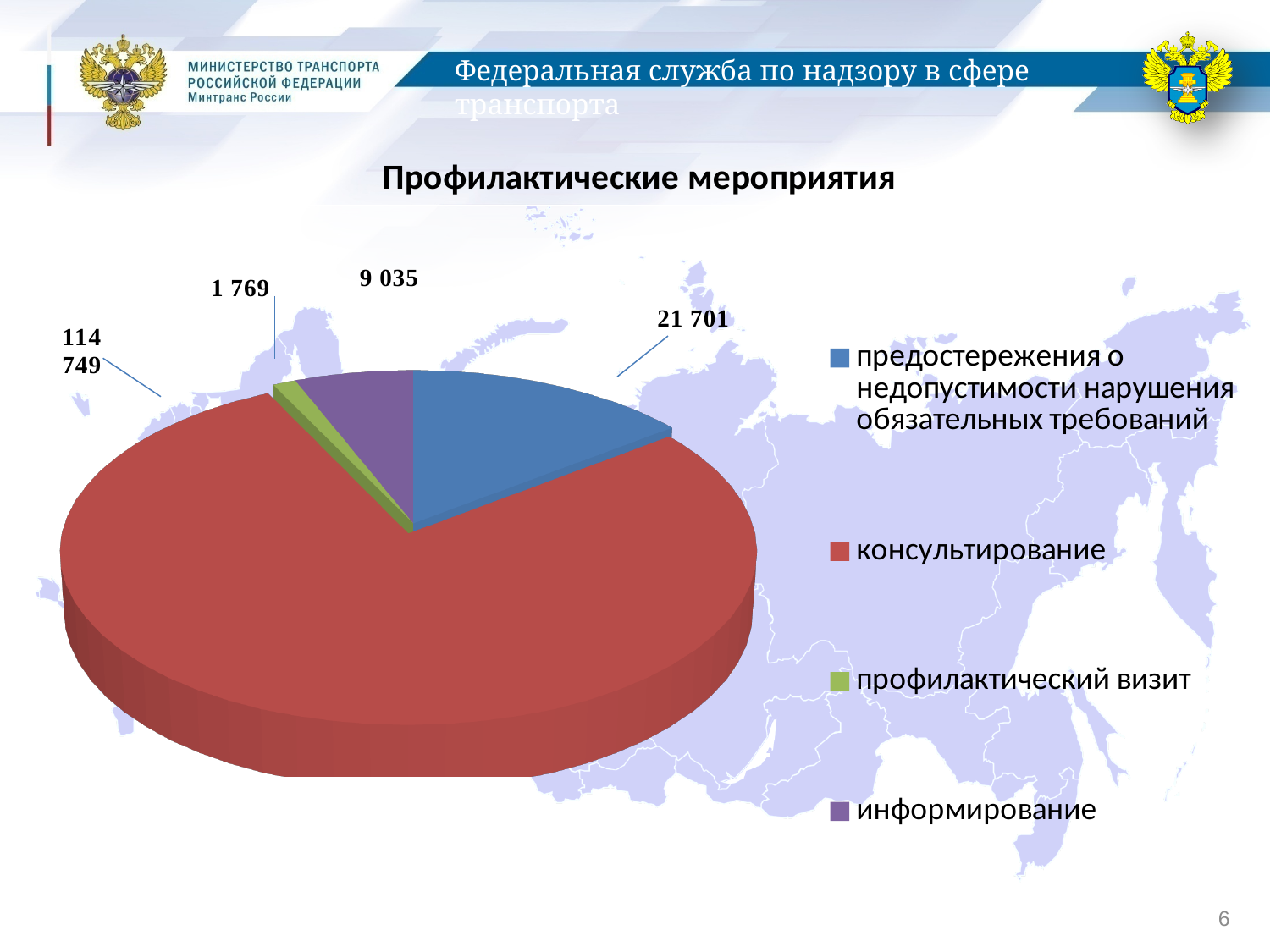
What is the value for "консультирование"? 114 749 Which colour represents "информирование" in the legend? purple Which category has the largest slice of the pie? консультирование Which category has the smallest slice of the pie? профилактический визит Which is larger: "информирование" or "предостережения о недопустимости нарушения обязательных требований"? предостережения о недопустимости нарушения обязательных требований What is the value for "предостережения о недопустимости нарушения обязательных требований"? 21 701 How many categories does the pie chart show? 4 What is the value for "профилактический визит"? 1 769 What is the value for "информирование"? 9 035 What type of chart is shown on the slide? pie chart What is the difference between the values for "консультирование" and "предостережения о недопустимости нарушения обязательных требований"? 93 048 What is the title of the chart on the slide? Профилактические мероприятия